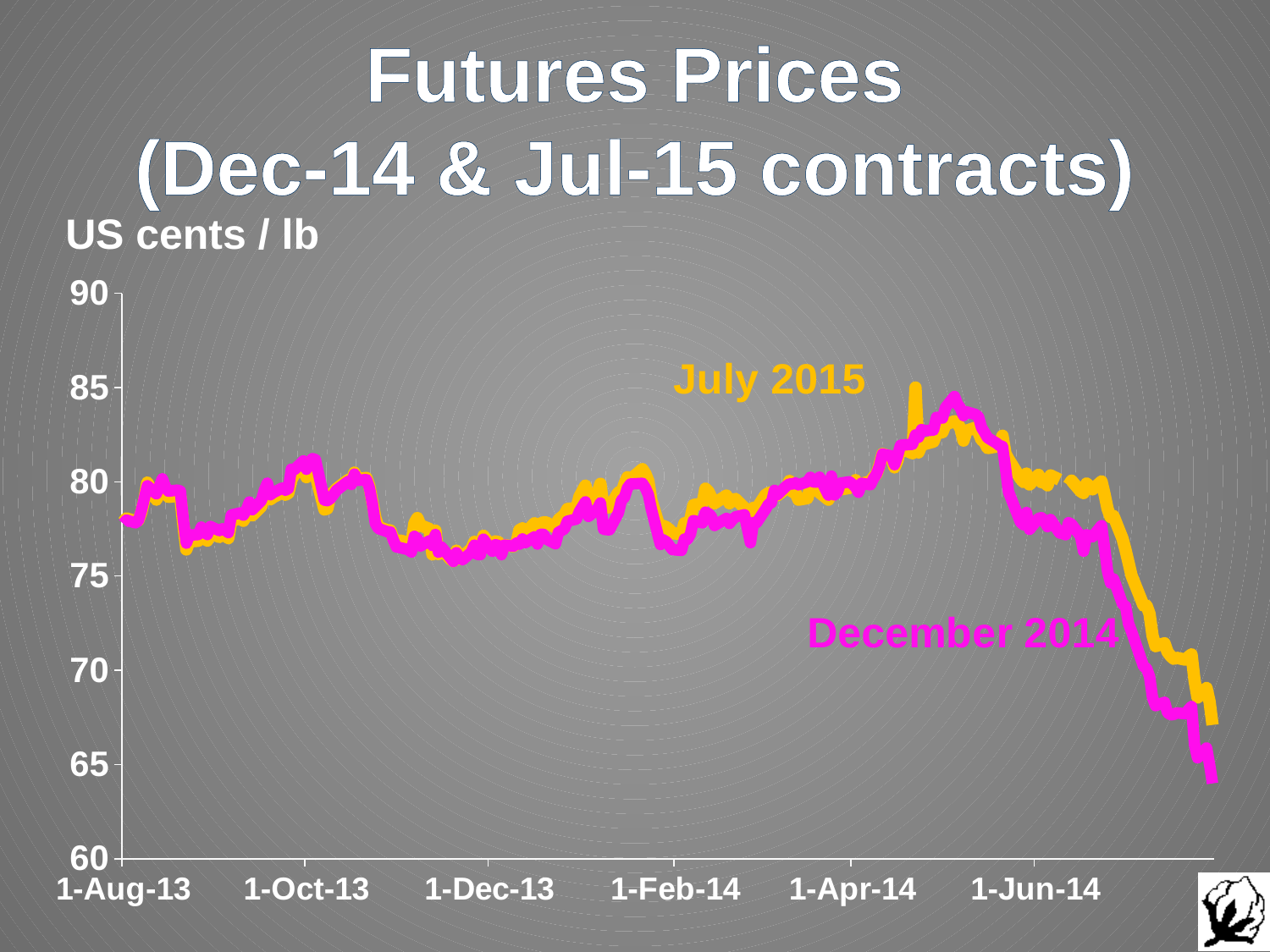
What unit is shown for the vertical axis of the chart? US cents / lb What kind of chart is shown on the slide? line chart How many series are plotted on the chart? 2 Is the value of the December 2014 series at 1-Aug-13 greater or less than 75? greater Overall, do the futures prices rise or fall from the start of the chart to the end? fall How many date labels are shown on the x axis? 6 At the right-hand end of the chart, which series is higher, July 2015 or December 2014? July 2015 Around which x-axis date do both series reach their highest values? between 1-Apr-14 and 1-Jun-14 Is the highest value reached by the December 2014 series greater or less than 80? greater Is the value of the December 2014 series at the right-hand end of the chart greater or less than 70? less What are the names of the two series plotted on the chart? July 2015 and December 2014